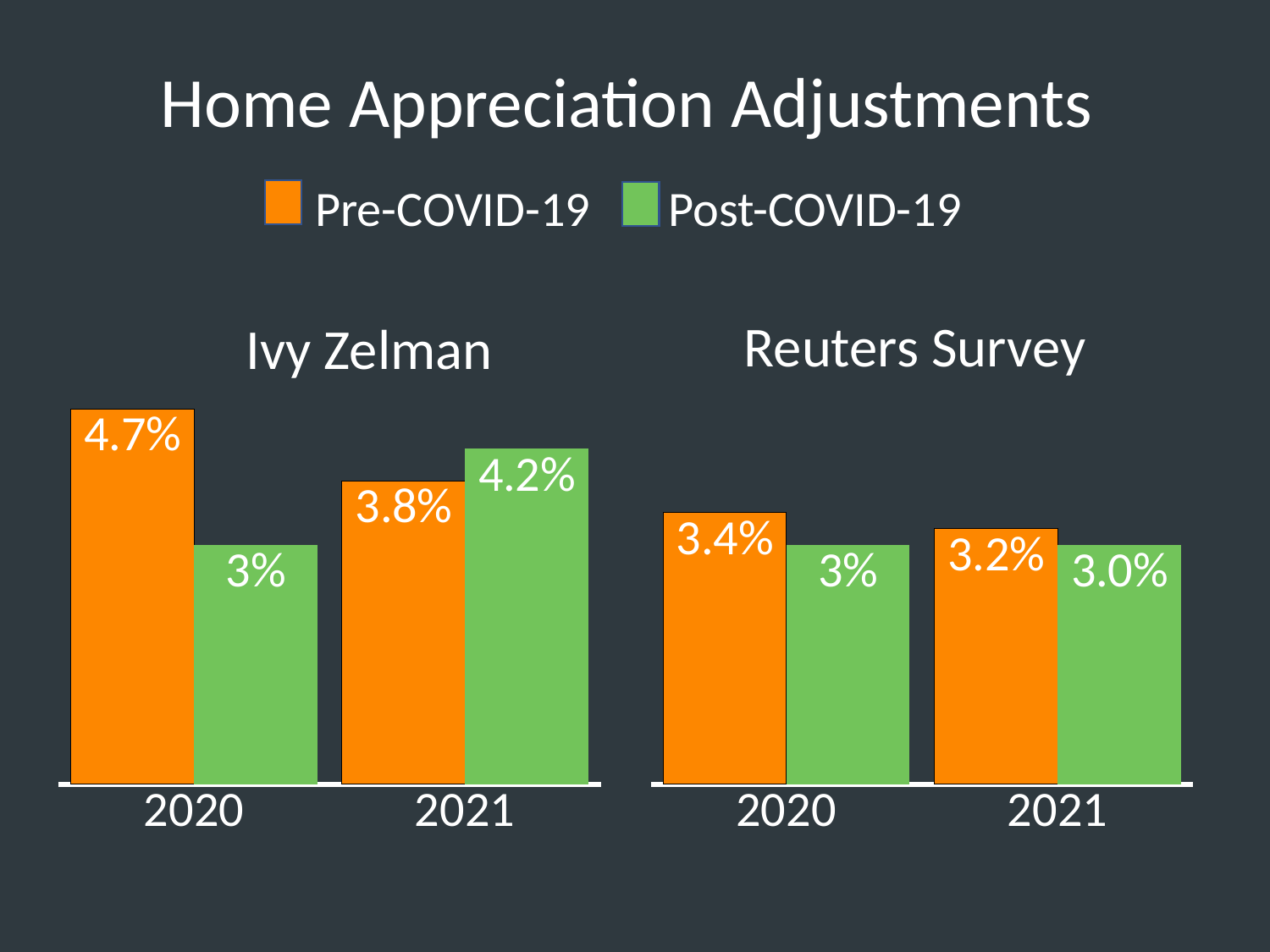
In the Ivy Zelman chart, what is the Post-COVID-19 value for 2021? 4.2% In the Ivy Zelman chart, which is larger for 2021: the Pre-COVID-19 value or the Post-COVID-19 value? Post-COVID-19 In the Ivy Zelman chart, which bar is the lowest? Post-COVID-19 2020 How many series does the legend list? 2 In the Reuters Survey chart, what is the difference between the Pre-COVID-19 values for 2020 and 2021? 0.2% In the Reuters Survey chart, what is the Pre-COVID-19 value for 2021? 3.2% What kind of chart is the Reuters Survey chart? Bar chart In the Ivy Zelman chart, what is the Pre-COVID-19 value for 2020? 4.7% In the Reuters Survey chart, what is the Post-COVID-19 value for 2020? 3% In the Ivy Zelman chart, what is the difference between the Pre-COVID-19 and Post-COVID-19 values for 2020? 1.7% In the Reuters Survey chart, which bar is the highest? Pre-COVID-19 2020 In the Ivy Zelman chart, which bar is the highest? Pre-COVID-19 2020